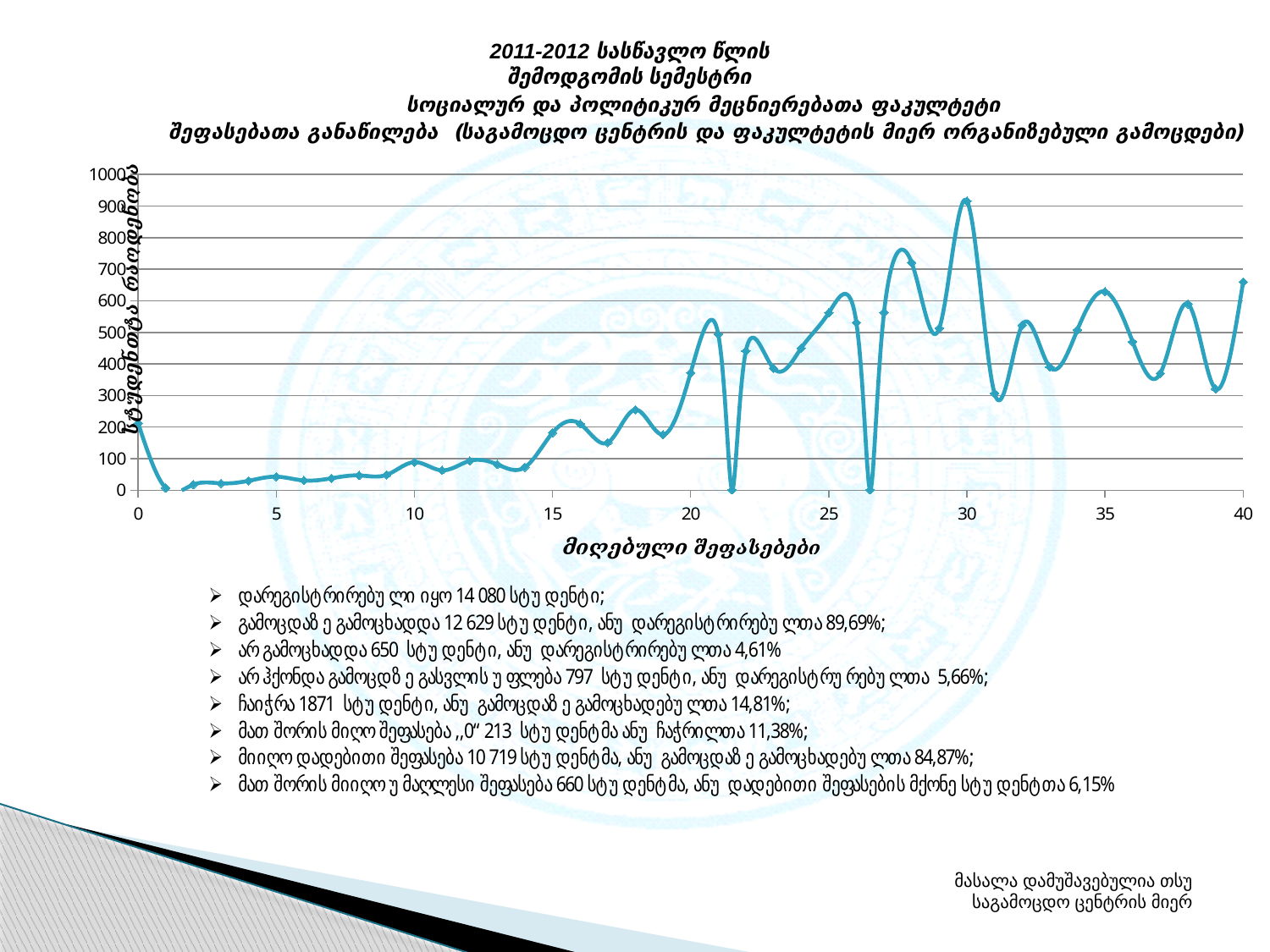
Which has more students: grade 40 or grade 10? grade 40 Which has more students: grade 30 or grade 0? grade 30 At which received grade (x-axis value) does the line reach its highest point? 30 Is the number of students at grade 5 greater or less than 100? less What is the title of the x axis of the chart? მიღებული შეფასებები Is the number of students at grade 0 greater or less than 300? less How many lines (series) are plotted on the chart? 1 Is the number of students at grade 30 greater or less than 800? greater What kind of chart is shown on the slide? line chart